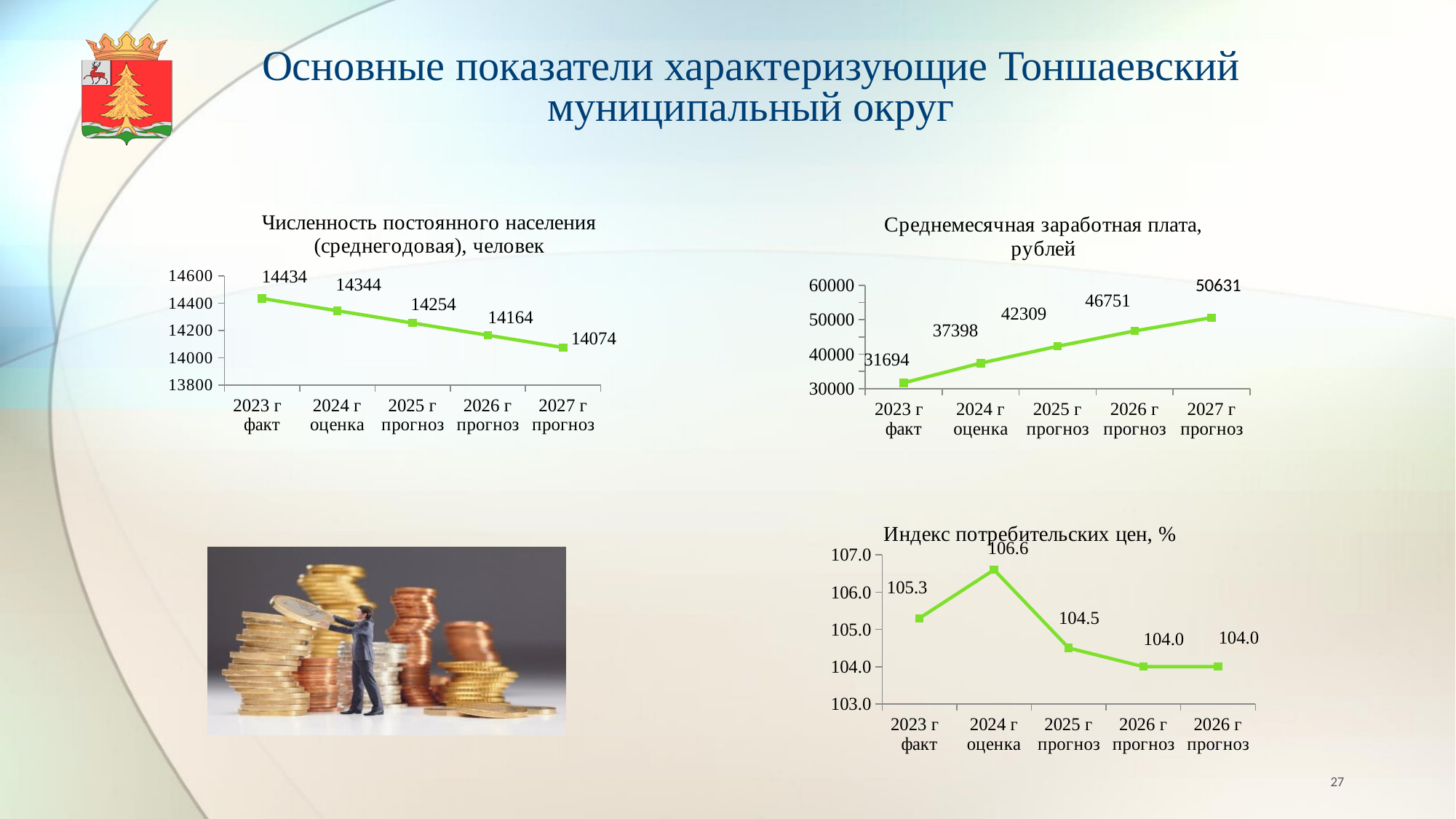
In the chart 'Среднемесячная заработная плата, рублей', what is the difference between the 2024 г оценка value and the 2023 г факт value? 5704 In the chart 'Среднемесячная заработная плата, рублей', what is the value for 2025 г прогноз? 42309 In the chart 'Индекс потребительских цен, %', which year has the highest value? 2024 г оценка In the chart 'Среднемесячная заработная плата, рублей', which year has the highest value? 2027 г прогноз In the chart 'Численность постоянного населения (среднегодовая), человек', what is the value for 2027 г прогноз? 14074 In the chart 'Численность постоянного населения (среднегодовая), человек', do the values rise or fall from 2023 to 2027? fall In the chart 'Численность постоянного населения (среднегодовая), человек', what is the value for 2023 г факт? 14434 What kind of chart is 'Индекс потребительских цен, %'? line chart In the chart 'Индекс потребительских цен, %', is the value for 2023 г факт larger or smaller than the value for 2025 г прогноз? larger In the chart 'Индекс потребительских цен, %', what is the value for 2024 г оценка? 106.6 In the chart 'Численность постоянного населения (среднегодовая), человек', what is the difference between the 2023 г факт value and the 2027 г прогноз value? 360 In the chart 'Среднемесячная заработная плата, рублей', how many data points are plotted? 5